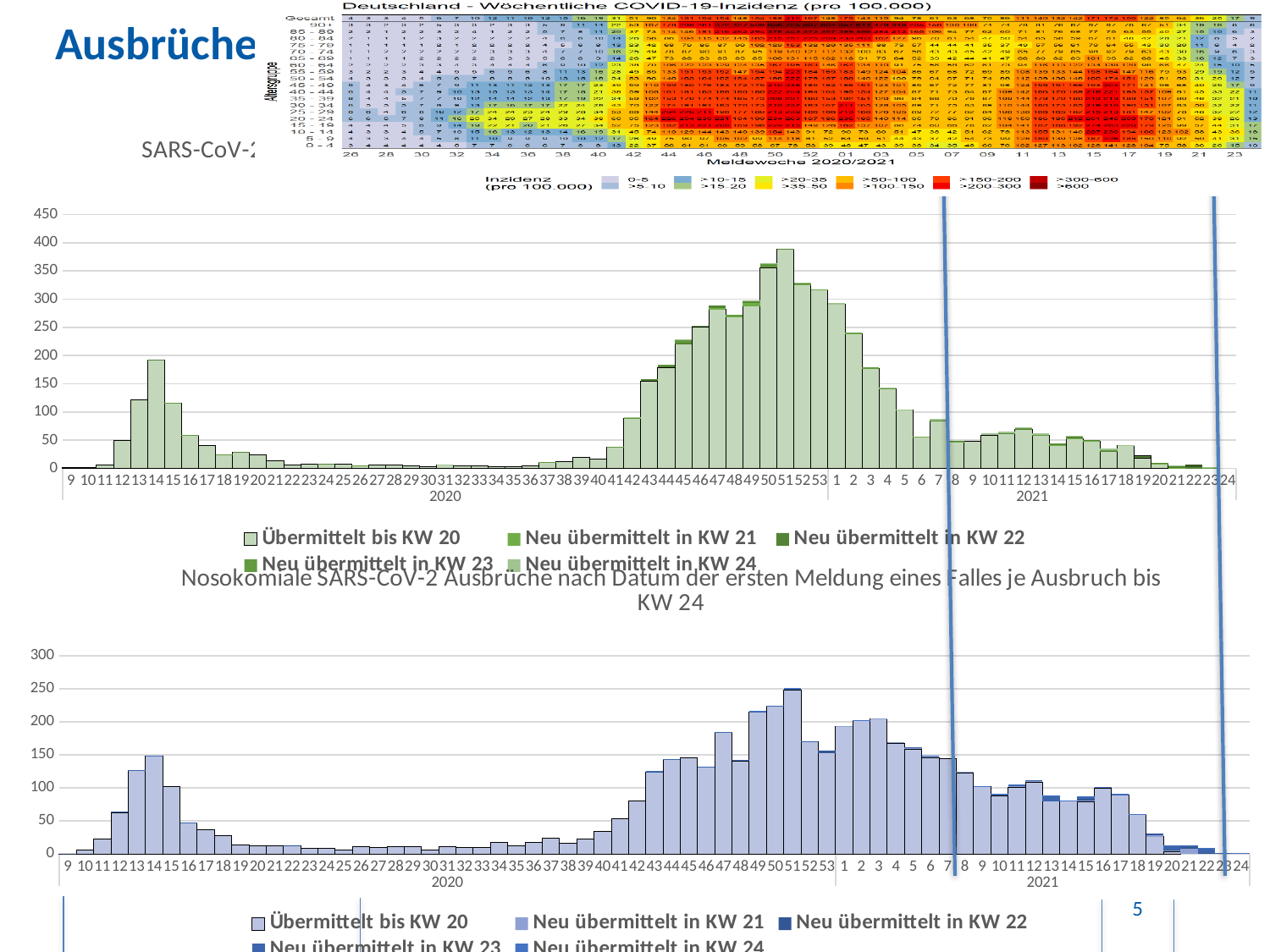
How many series does the legend of the lower (blue) chart list? 5 In the lower (blue) chart, which calendar week has the highest bar? 51 (2020) In the upper (green) chart, which calendar week has the highest bar? 51 (2020) In the lower (blue) chart, is the value for week 30 of 2020 greater or less than 50? less In the upper (green) chart, is the value for week 51 of 2020 greater or less than 350? greater How many series does the legend of the upper (green) chart list? 5 In the lower (blue) chart, is the value for week 51 of 2020 greater or less than 200? greater What kind of chart is the upper chart on the slide (the green one)? bar chart In the upper (green) chart, do the values rise or fall from week 51 of 2020 to week 24 of 2021? fall In the upper (green) chart, which is larger: the bar for week 14 of 2020 or the bar for week 51 of 2020? week 51 of 2020